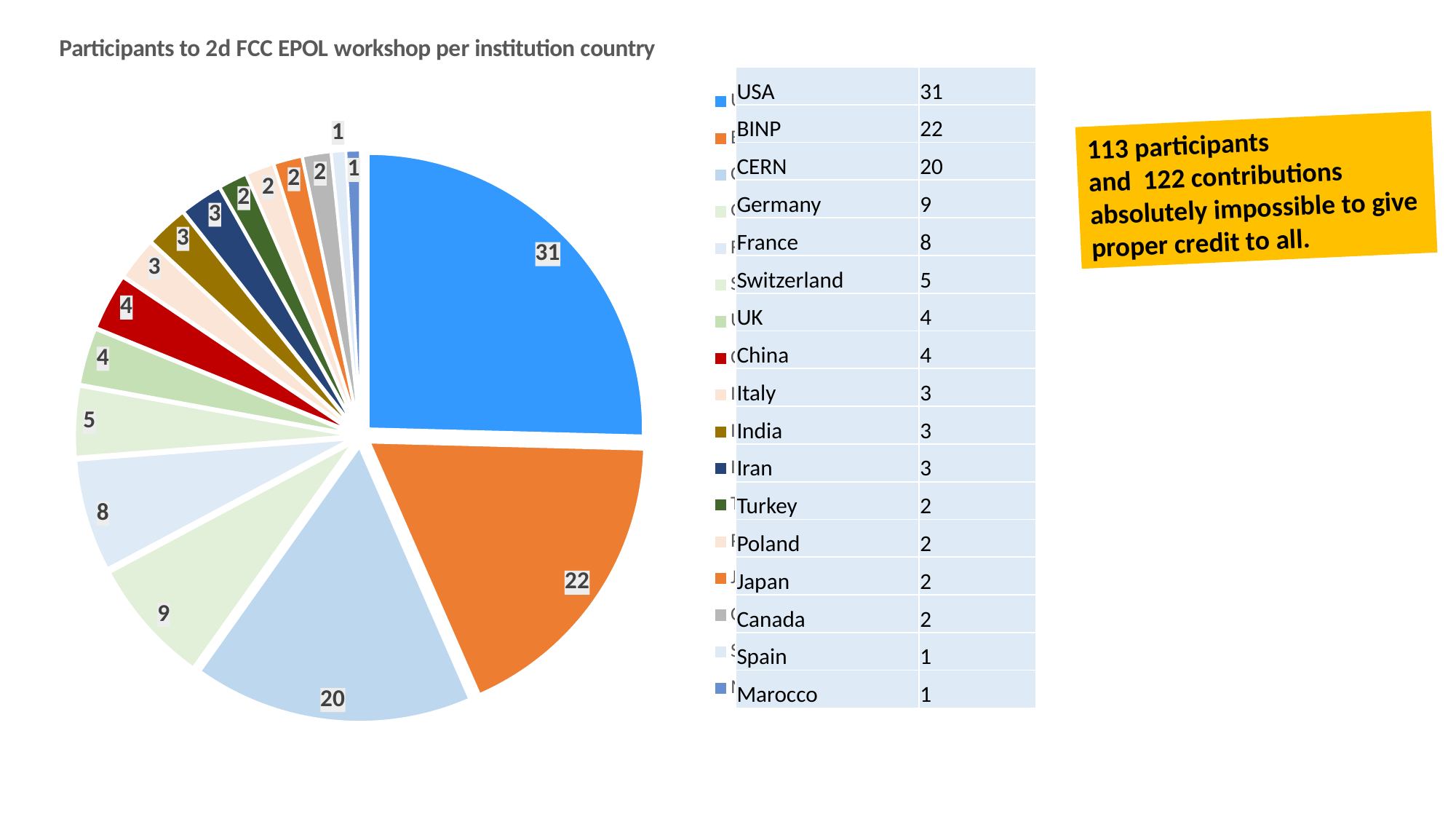
What is the title of the chart? Participants to 2d FCC EPOL workshop per institution country How many categories (countries/institutions) are listed in the chart? 17 Which is larger, the value for Germany or the value for France? Germany What kind of chart is shown on the slide? Pie chart What is the value for CERN? 20 Which categories have the smallest value in the chart? Spain and Marocco What is the value for Germany? 9 What is the difference between the values for USA and BINP? 9 What is the value for BINP? 22 What is the value for Switzerland? 5 Which category has the largest slice of the pie? USA How many participants are from USA institutions? 31